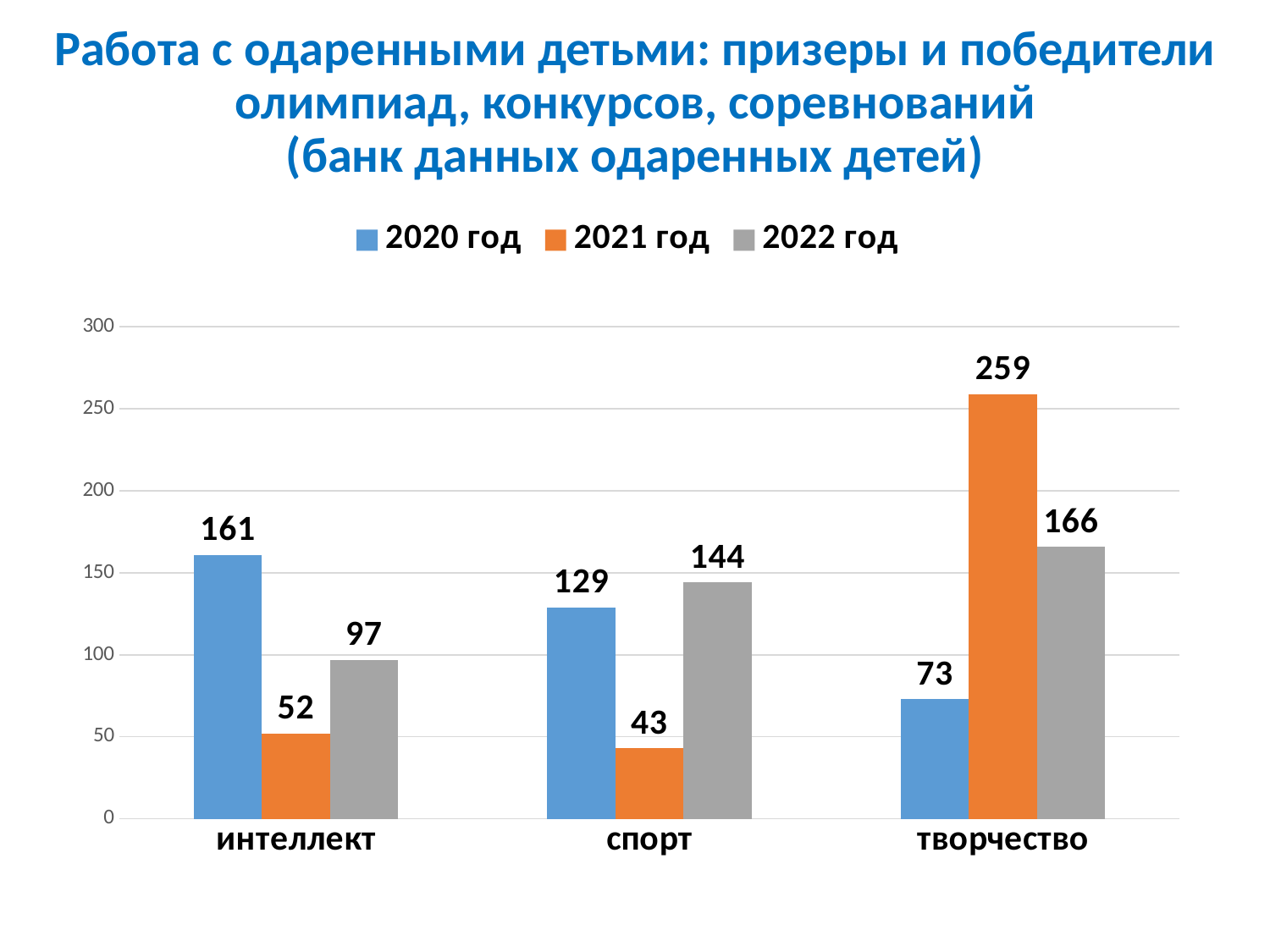
What is the value for 2021 год in the творчество category? 259 What is the difference between the 2022 год and 2021 год values in the интеллект category? 45 Which is larger in the спорт category: the value for 2020 год or for 2022 год? 2022 год What is the value for 2022 год in the спорт category? 144 What is the value for 2020 год in the интеллект category? 161 What kind of chart is shown on the slide? bar chart Is the value for 2021 год in the творчество category greater or less than 250? greater Which colour represents the 2022 год series? grey How many series does the legend list? 3 Which category has the highest value for 2021 год? творчество Which category has the lowest value for 2020 год? творчество How many categories are shown on the x axis? 3